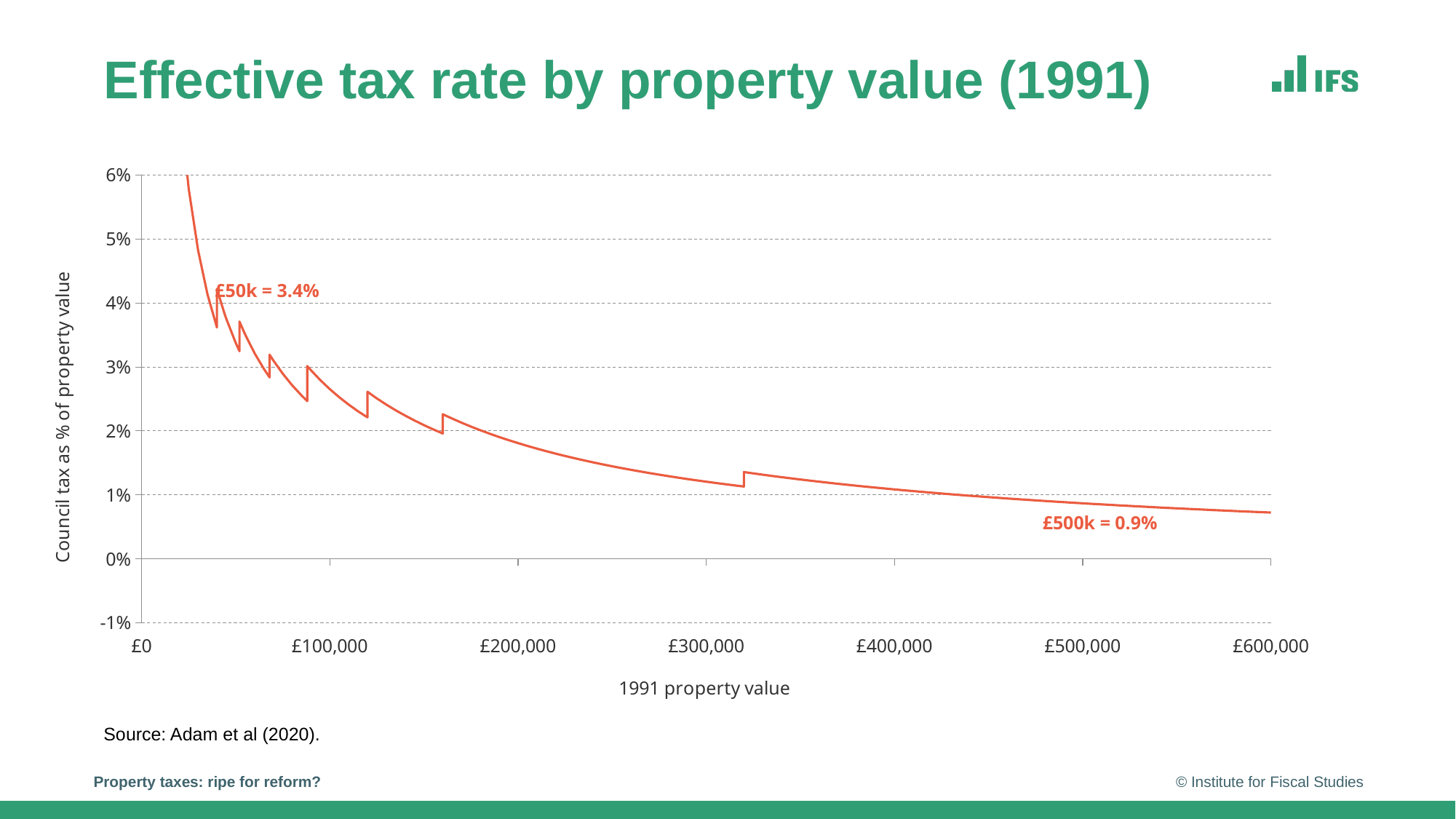
What is the difference between the labelled effective tax rates at £50k and £500k? 2.5% According to the label on the chart, what is the effective council tax rate for a property valued at £500k? 0.9% According to the label on the chart, what is the effective council tax rate for a property valued at £50k? 3.4% What type of chart is shown on the slide? line chart Is the effective tax rate at a property value of £600,000 greater or less than 1%? less Is the effective tax rate at a property value of £300,000 greater or less than 2%? less Which has the higher labelled effective tax rate, a £50k property or a £500k property? £50k Overall, does the effective tax rate rise or fall as 1991 property value increases? fall Is the effective tax rate at a property value of £100,000 greater or less than 2%? greater What is the title of the chart? Effective tax rate by property value (1991) What is the label on the vertical axis of the chart? Council tax as % of property value